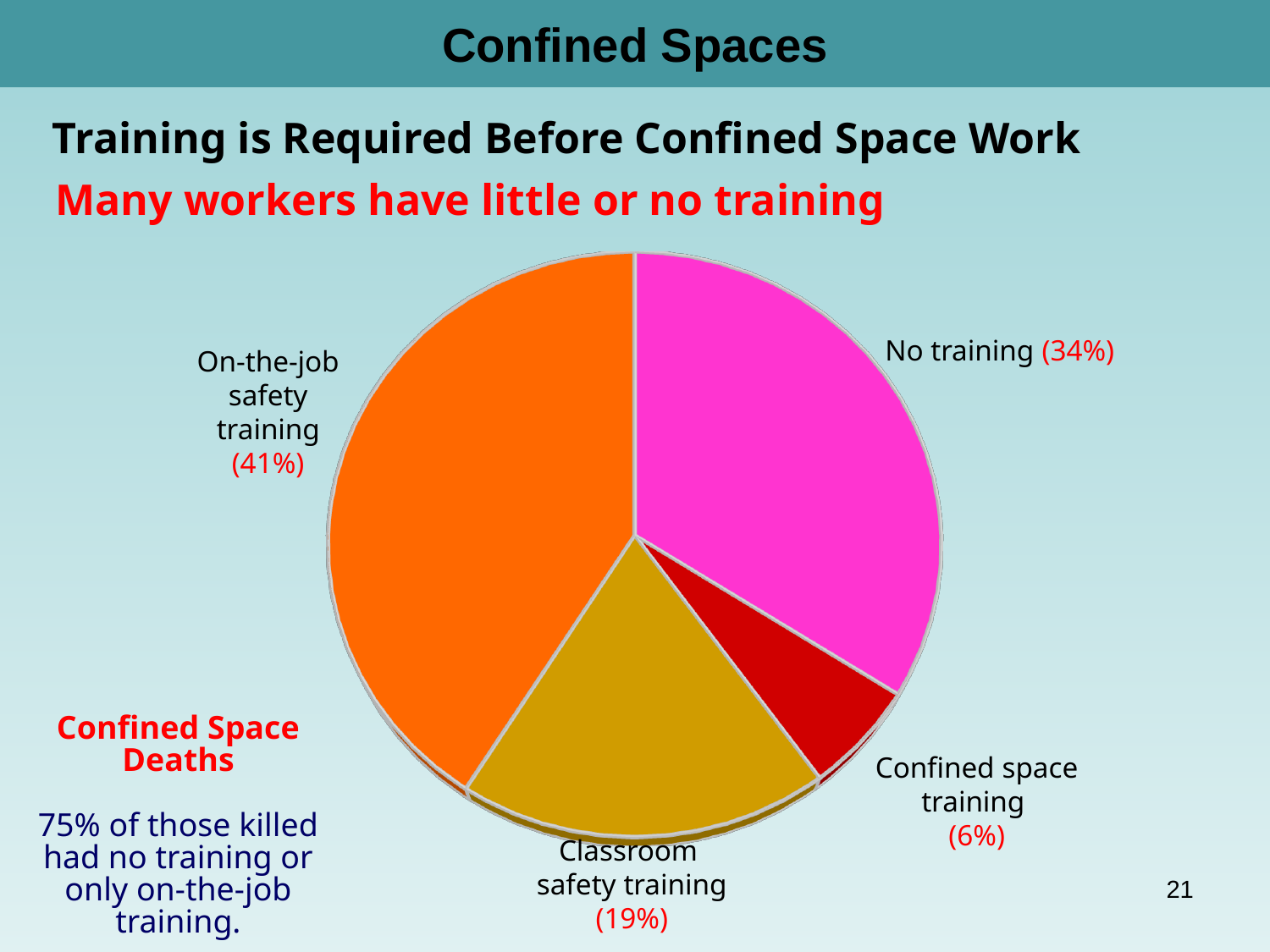
What is the difference in percentage points between the "On-the-job safety training" slice and the "No training" slice? 7% What is the combined share of the "No training" and "On-the-job safety training" slices? 75% What share of the pie is labelled "On-the-job safety training"? 41% Which category has the largest slice of the pie? On-the-job safety training What share of the pie is labelled "Classroom safety training"? 19% What kind of chart is shown on the slide? pie chart Which is larger, the "Classroom safety training" slice or the "Confined space training" slice? Classroom safety training What share of the pie is labelled "No training"? 34% What colour is the "No training" slice of the pie? pink How many slices does the pie chart have? 4 Which category has the smallest slice of the pie? Confined space training